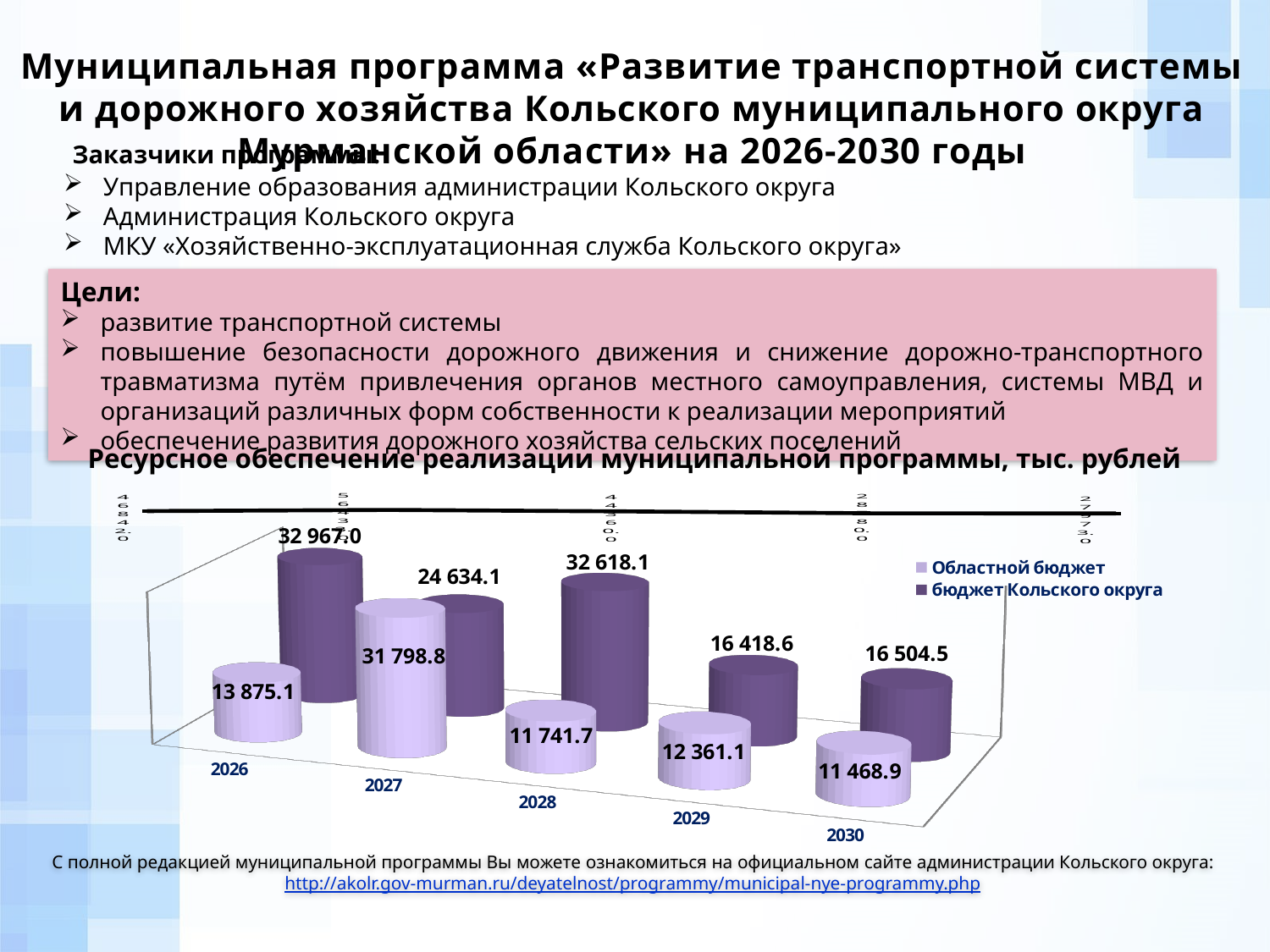
How many years are shown on the x axis of the chart? 5 Which is larger in 2027: «Областной бюджет» or «бюджет Кольского округа»? Областной бюджет In which year is «Областной бюджет» the highest? 2027 What is the difference between «бюджет Кольского округа» and «Областной бюджет» in 2026? 19 091.9 What type of chart is shown on the slide? bar chart What is the value of «Областной бюджет» for 2029? 12 361.1 What is the value of «бюджет Кольского округа» for 2030? 16 504.5 In which year is «Областной бюджет» the lowest? 2030 How many series does the chart legend list? 2 What is the value of «бюджет Кольского округа» for 2028? 32 618.1 What is the value of «Областной бюджет» for 2026? 13 875.1 What unit is stated in the chart title for the values? тыс. рублей